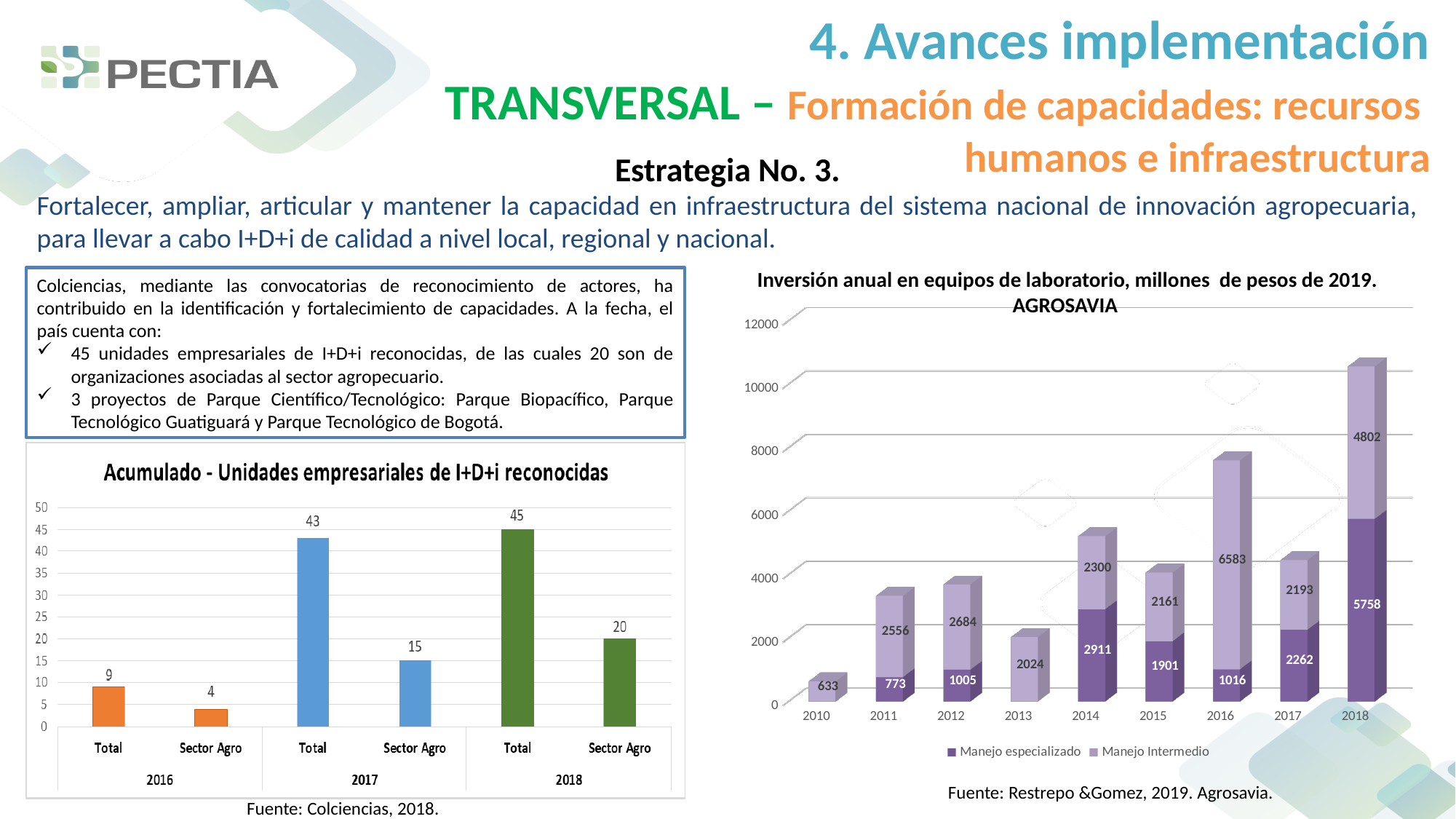
In the 'Acumulado - Unidades empresariales de I+D+i reconocidas' chart, which bar has the lowest value? Sector Agro 2016 In the 'Inversión anual en equipos de laboratorio' chart, how many series does the legend list? 2 In the 'Acumulado - Unidades empresariales de I+D+i reconocidas' chart, what is the difference between the Total and Sector Agro values for 2016? 5 In the 'Inversión anual en equipos de laboratorio' chart, what is the Manejo Intermedio value for 2016? 6583 In the 'Inversión anual en equipos de laboratorio' chart, what is the total of the stacked bar for 2018? 10560 In the 'Inversión anual en equipos de laboratorio' chart, which is larger for 2015: Manejo especializado or Manejo Intermedio? Manejo Intermedio In the 'Inversión anual en equipos de laboratorio' chart, what is the Manejo especializado value for 2018? 5758 In the 'Acumulado - Unidades empresariales de I+D+i reconocidas' chart, do the Total values rise or fall from 2016 to 2018? rise In the 'Inversión anual en equipos de laboratorio' chart, how many years are shown on the x axis? 9 In the 'Acumulado - Unidades empresariales de I+D+i reconocidas' chart, what is the Total value for 2017? 43 In the 'Acumulado - Unidades empresariales de I+D+i reconocidas' chart, what is the Sector Agro value for 2018? 20 What kind of chart is the 'Inversión anual en equipos de laboratorio' chart? stacked bar chart